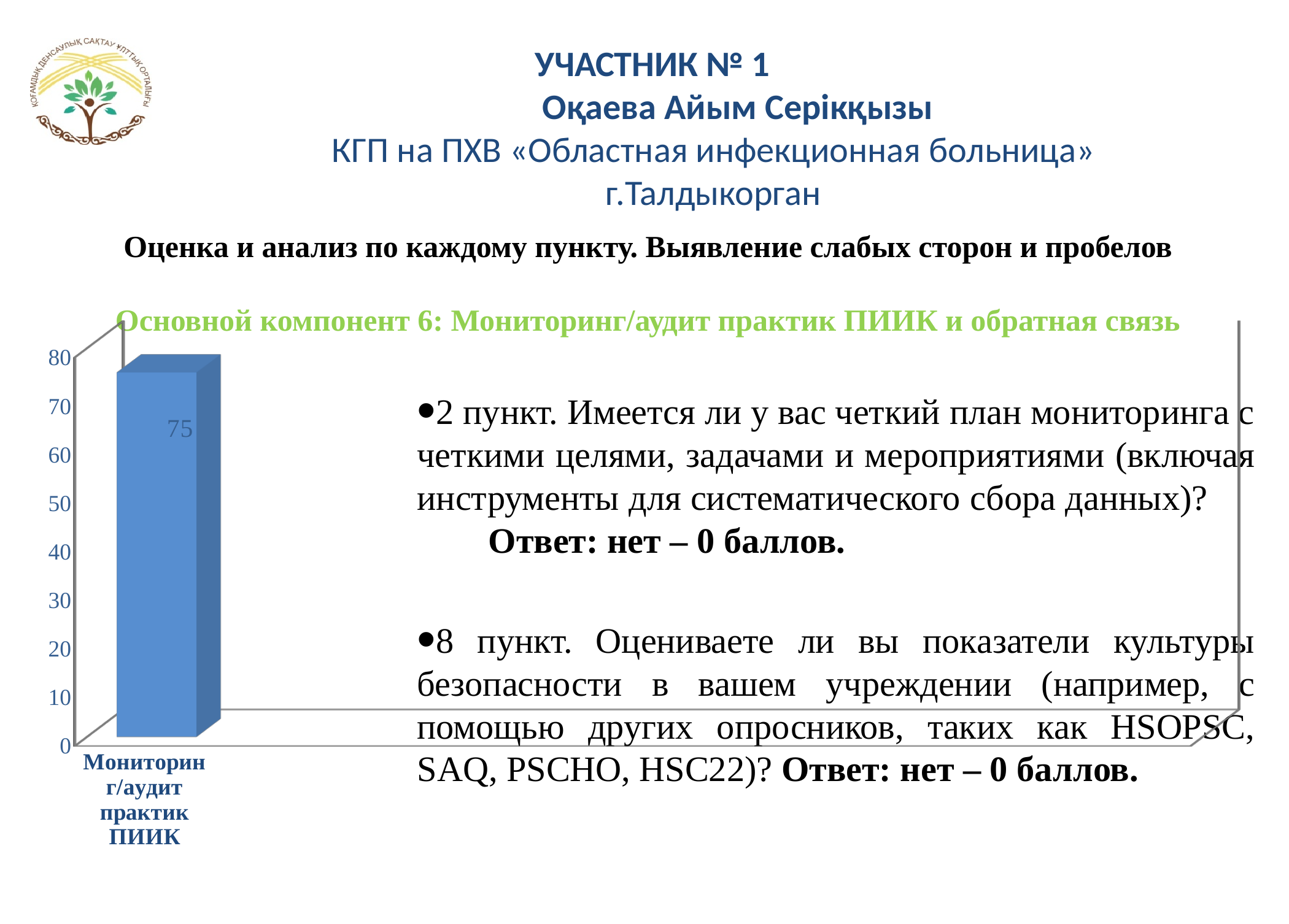
How many bars are plotted in the chart? 1 What is the highest value shown on the chart's vertical axis? 80 What kind of chart is shown on the slide? bar chart Is the value for "Мониторинг/аудит практик ПИИК" greater or less than 70? greater Is the value for "Мониторинг/аудит практик ПИИК" greater or less than 80? less What value is shown for the bar labelled "Мониторинг/аудит практик ПИИК"? 75 What is the title of the chart? Основной компонент 6: Мониторинг/аудит практик ПИИК и обратная связь